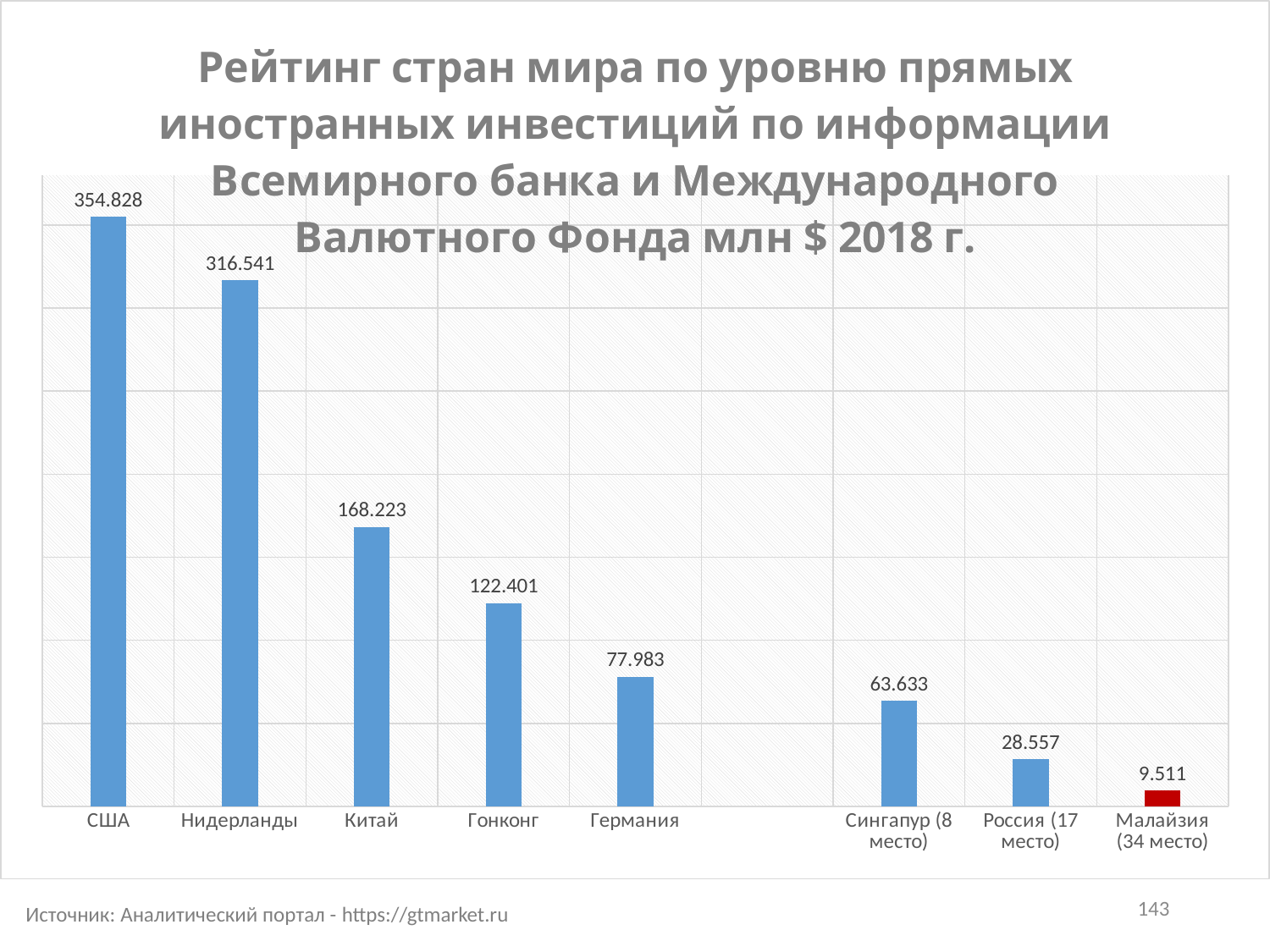
What is the difference between the values for США and Нидерланды? 38.287 What is the value shown for Малайзия (34 место)? 9.511 What is the value shown for Россия (17 место)? 28.557 What is the value shown for Китай? 168.223 Which country has the highest value on the chart? США What is the difference between the values for Китай and Гонконг? 45.822 Which is larger, the value for Германия or the value for Сингапур (8 место)? Германия Which country has the lowest value on the chart? Малайзия (34 место) How many countries have bars on the chart? 8 What kind of chart is shown on the slide? Bar chart What is the value shown for США? 354.828 Which bar is coloured red instead of blue? Малайзия (34 место)